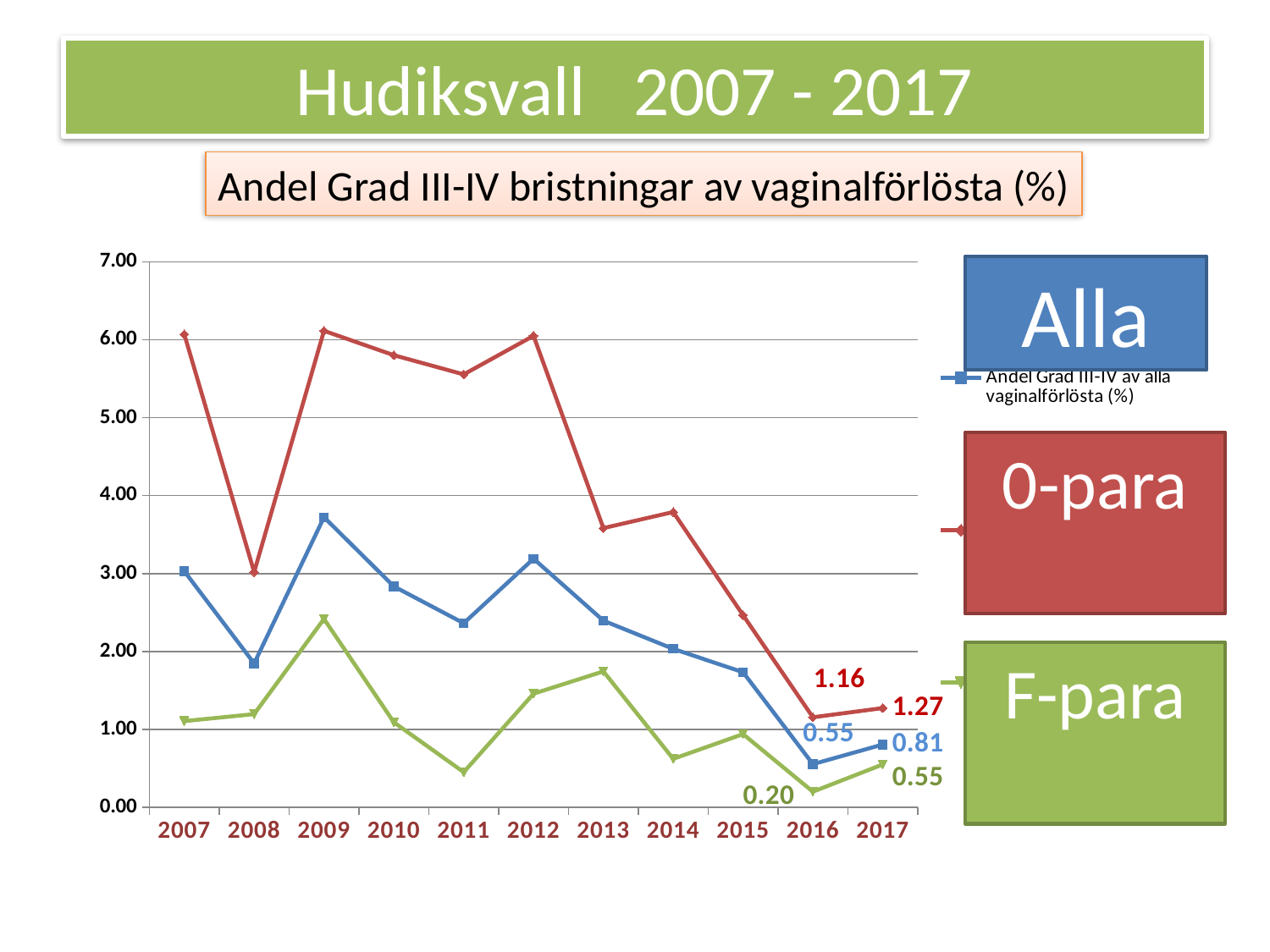
What is the Alla value for 2016? 0.55 How many years are plotted along the x axis? 11 What is the F-para value for 2016? 0.20 Is the F-para value for 2011 greater or less than 1.00? less What is the 0-para value for 2017? 1.27 Is the 0-para value for 2007 greater or less than 5.00? greater Which series has the highest value in 2012? 0-para What is the difference between the 0-para and Alla values in 2017? 0.46 In which year is the F-para series at its lowest? 2016 Does the Alla series rise or fall from 2012 to 2016? fall How many series are plotted in the chart? 3 What kind of chart is shown on the slide? line chart